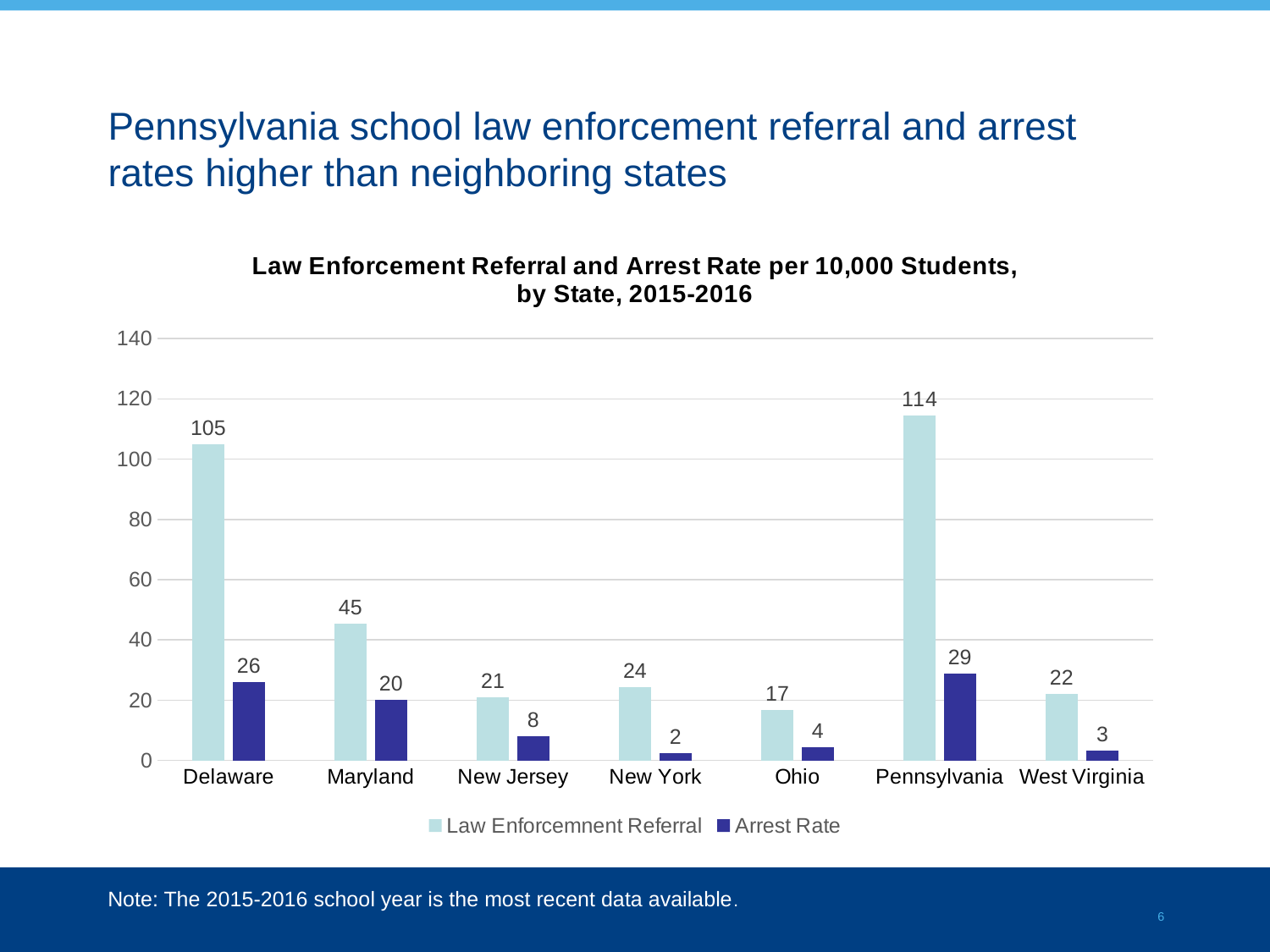
What kind of chart is shown on the slide? Bar chart Is the Law Enforcement Referral rate for Maryland greater or less than 40? greater What is the Arrest Rate for Maryland? 20 What is the Law Enforcement Referral rate for Pennsylvania? 114 Which is larger, the Arrest Rate for Delaware or the Arrest Rate for Pennsylvania? Pennsylvania How many series does the legend list? 2 How many states are shown on the x axis? 7 Which state has the highest Law Enforcement Referral rate? Pennsylvania What is the title of the chart? Law Enforcement Referral and Arrest Rate per 10,000 Students, by State, 2015-2016 What is the difference between the Law Enforcement Referral rates of Pennsylvania and Delaware? 9 Which state has the lowest Arrest Rate? New York What is the difference between the Law Enforcement Referral rate and the Arrest Rate for New Jersey? 13